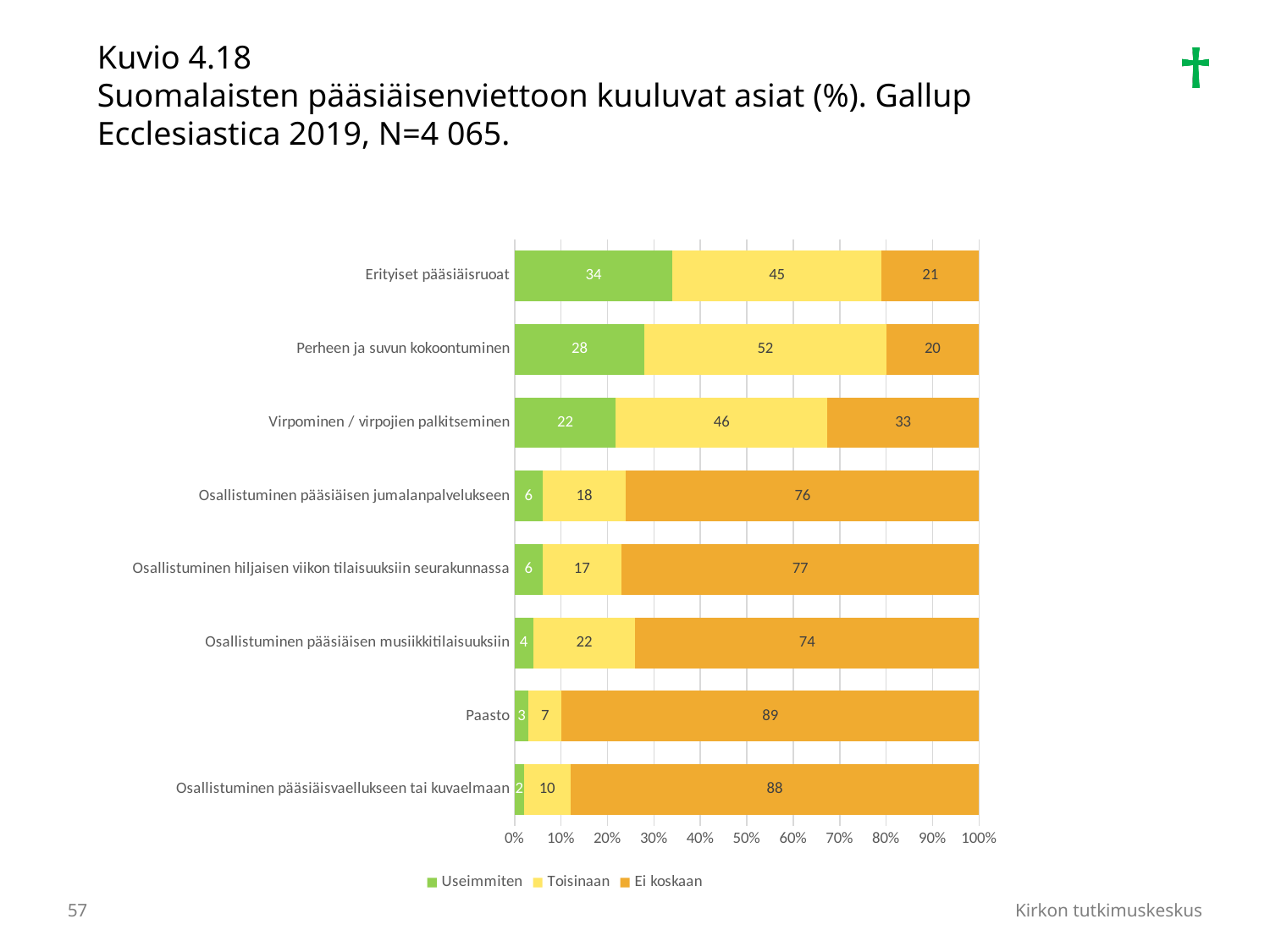
What is the total of the stacked bar for "Osallistuminen pääsiäisen jumalanpalvelukseen"? 100 Which is larger: the "Toisinaan" value for "Erityiset pääsiäisruoat" or for "Virpominen / virpojien palkitseminen"? Virpominen / virpojien palkitseminen Which category has the lowest "Useimmiten" value? Osallistuminen pääsiäisvaellukseen tai kuvaelmaan What kind of chart is shown on the slide? Stacked bar chart What is the difference between the "Ei koskaan" values for "Virpominen / virpojien palkitseminen" and "Erityiset pääsiäisruoat"? 12 Which category has the highest "Ei koskaan" value? Paasto What is the value of "Useimmiten" for "Erityiset pääsiäisruoat"? 34 Which series is shown in green in the legend? Useimmiten What is the value of "Toisinaan" for "Perheen ja suvun kokoontuminen"? 52 What is the value of "Ei koskaan" for "Paasto"? 89 How many series does the legend list? 3 How many categories are shown on the chart? 8